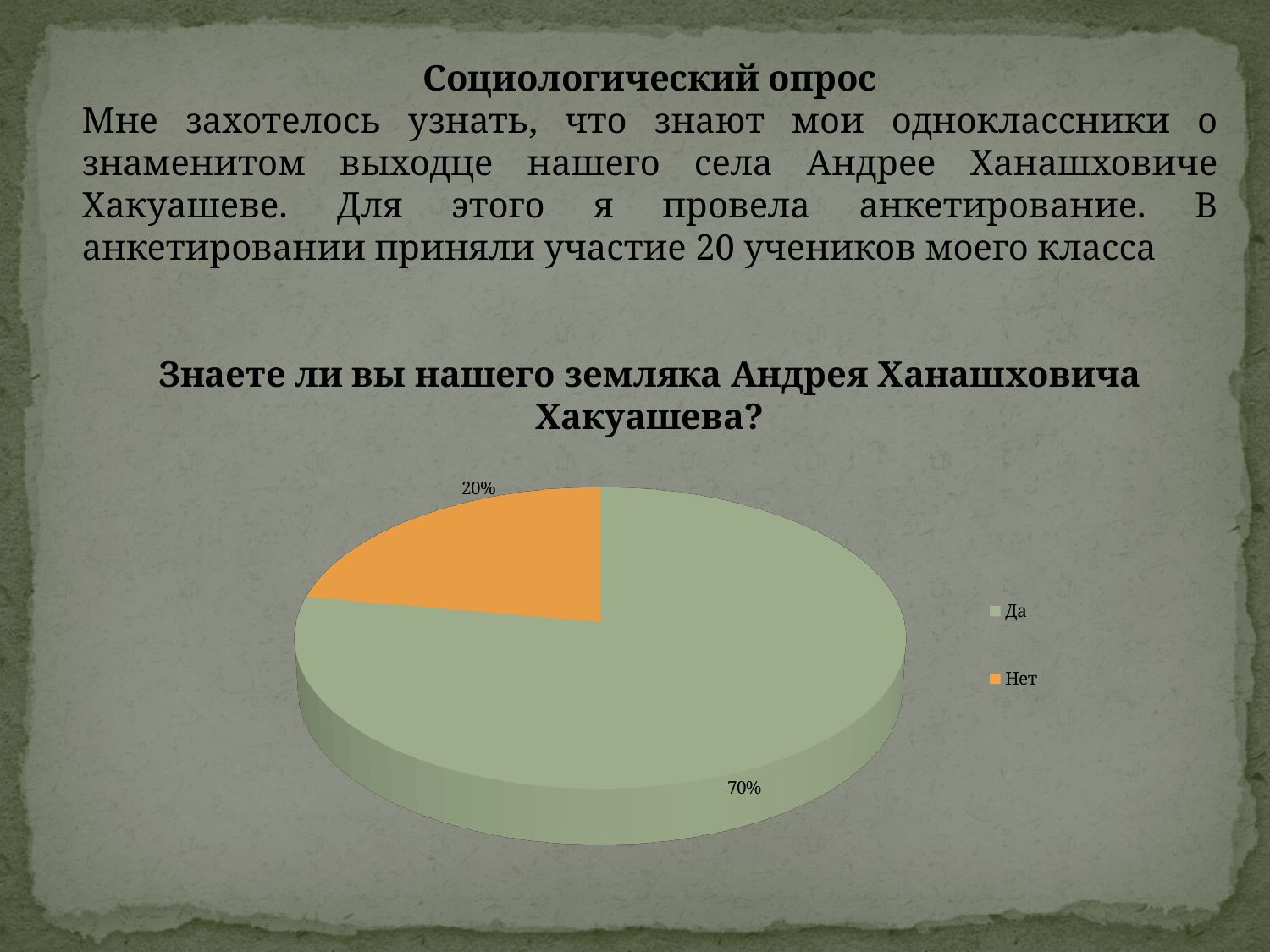
What percentage is shown for the "Да" slice of the pie chart? 70% How many entries does the legend of the pie chart list? 2 How many slices does the pie chart have? 2 What colour is the "Нет" slice in the pie chart? orange What is the difference in percentage points between the "Да" and "Нет" slices? 50 What percentage is shown for the "Нет" slice of the pie chart? 20% What share of the pie does the "Нет" slice represent according to its label? 20% Which slice of the pie chart is the smallest? Нет Which slice of the pie chart is the largest? Да What kind of chart is shown on the slide? pie chart Which is larger in the pie chart, "Да" or "Нет"? Да What is the title of the pie chart? Знаете ли вы нашего земляка Андрея Ханашховича Хакуашева?